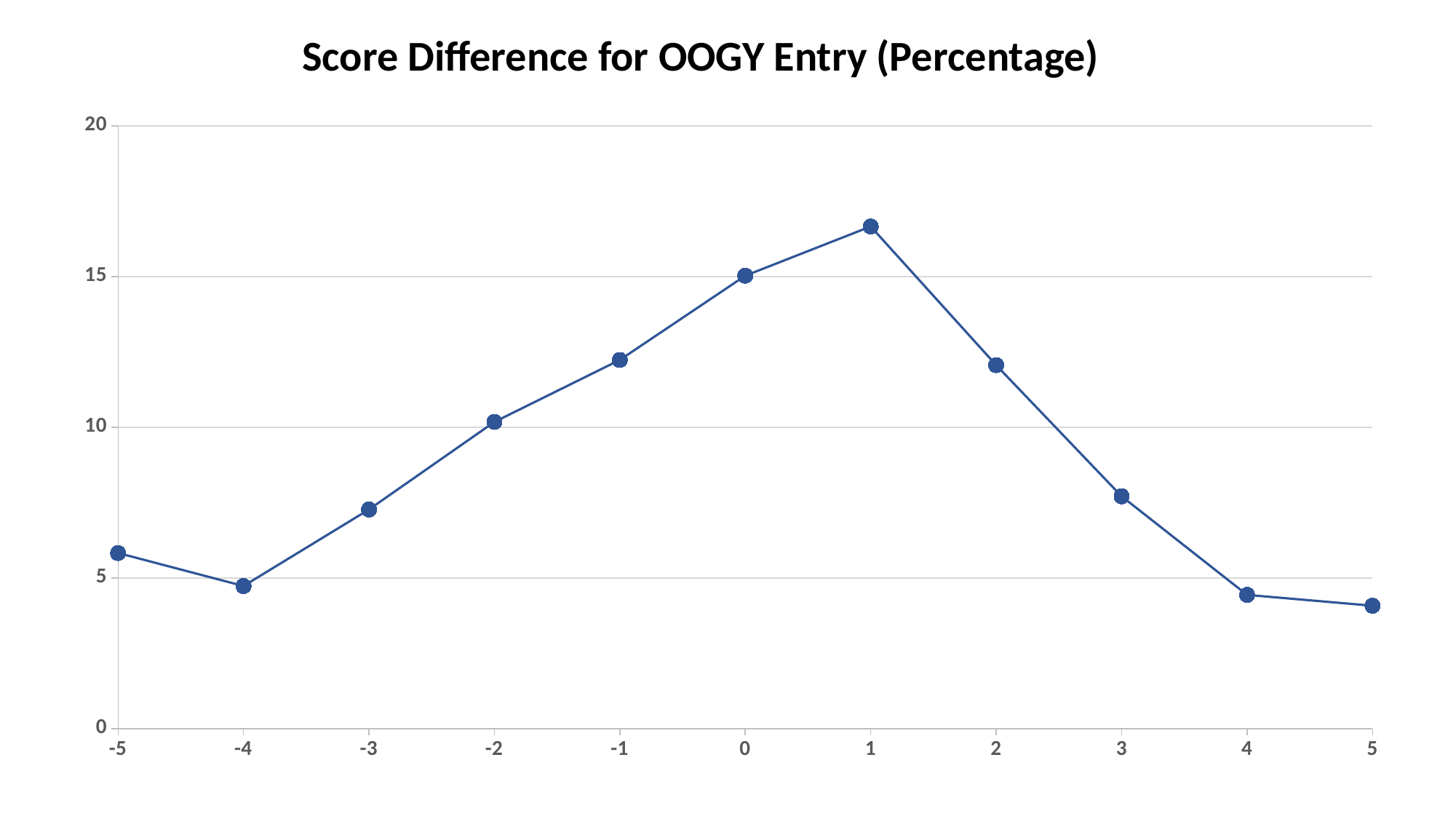
Is the value at x = -1 greater or less than 10? greater Is the value at x = 1 greater or less than 15? greater Do the values rise or fall as x goes from 1 to 5? fall How many data points are plotted on the line? 11 At which x-axis value is the plotted value highest? 1 Which has the larger value, x = -1 or x = 3? -1 What is the title of the chart? Score Difference for OOGY Entry (Percentage) Do the values rise or fall as x goes from -4 to 1? rise What kind of chart is shown on the slide? line chart Is the value at x = -3 greater or less than 5? greater